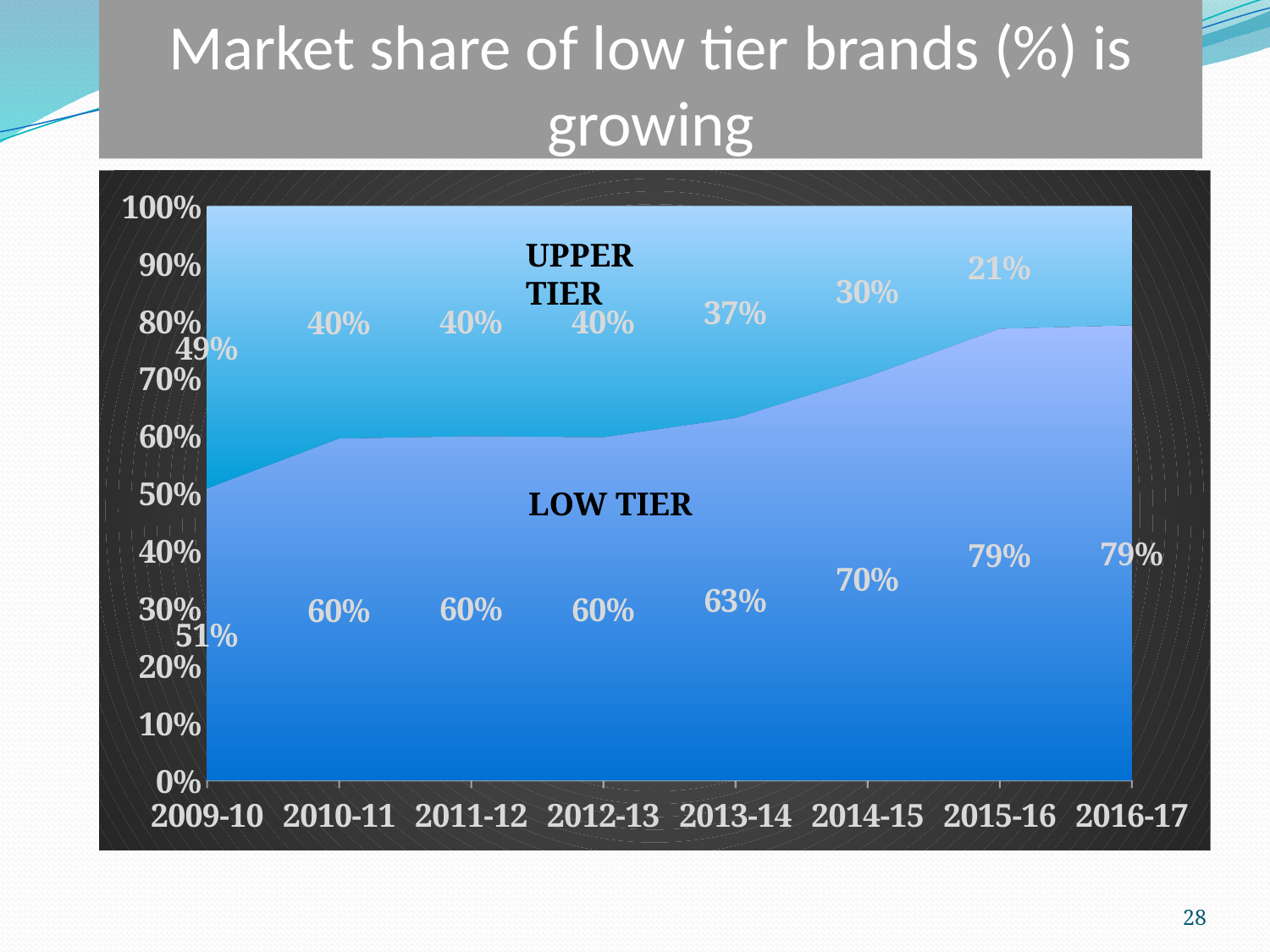
By how many percentage points did the low tier share increase from 2009-10 to 2015-16? 28 Which is larger in 2014-15, the low tier share or the upper tier share? Low tier What is the market share of upper tier brands in 2013-14? 37% In which year is the upper tier share the highest? 2009-10 What kind of chart is shown on the slide? Area chart How many series (tiers) are plotted in the chart? 2 What is the low tier share in 2009-10? 51% Does the low tier share rise or fall from 2009-10 to 2016-17? Rise In which year is the low tier share the lowest? 2009-10 What is the market share of low tier brands in 2014-15? 70% What is the upper tier share in 2015-16? 21% How many years are shown on the x axis? 8